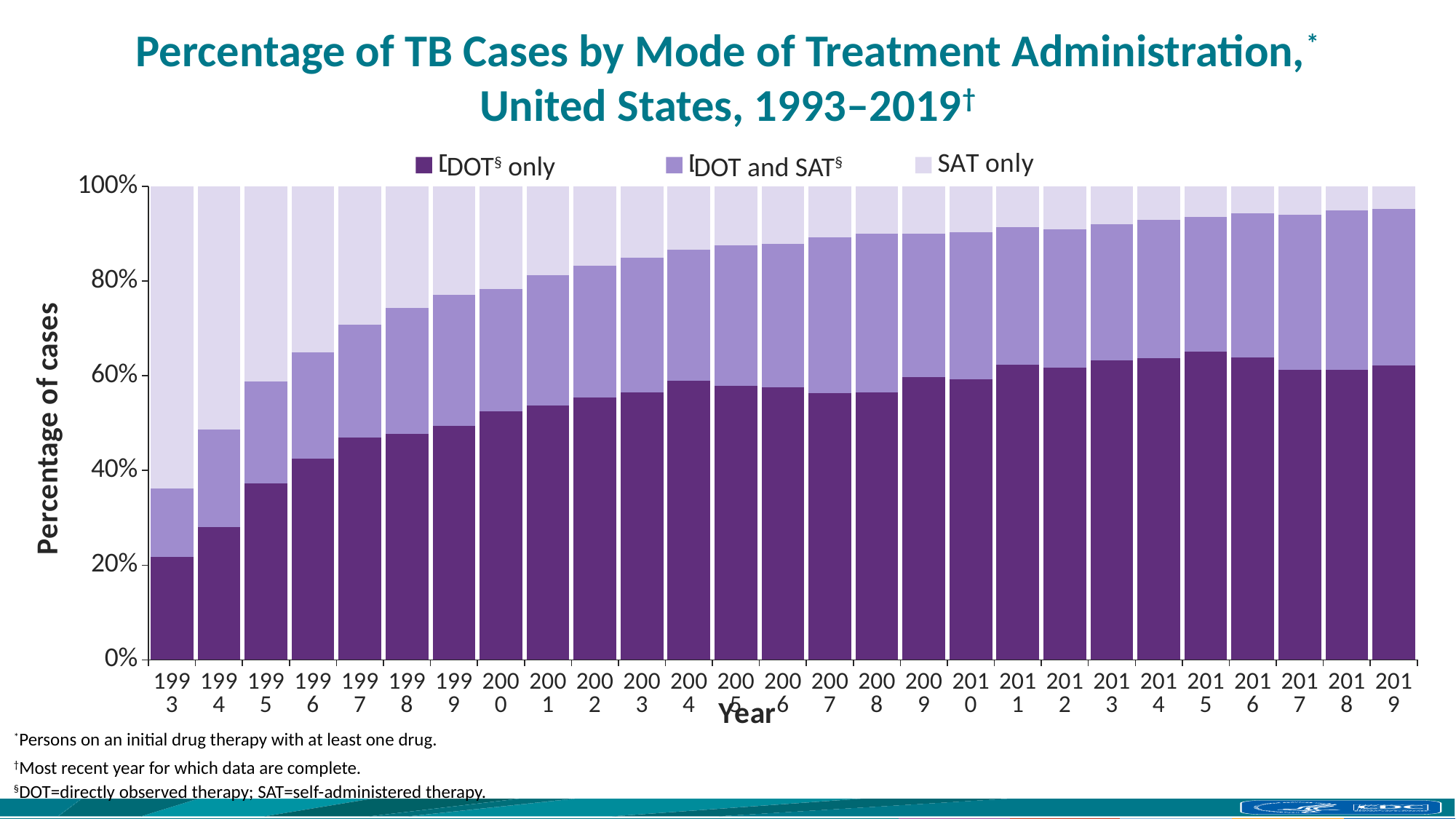
Which year has the larger DOT only share, 1993 or 2019? 2019 How many years are shown along the x axis? 27 Is the DOT only share for 1993 greater or less than 20%? greater How many series does the legend list? 3 Is the DOT only share for 1994 greater or less than 40%? less In which year is the SAT only share the largest? 1993 In which year is the DOT only share the lowest? 1993 Is the SAT only share for 1993 greater or less than 60%? greater What is the label on the y axis? Percentage of cases What kind of chart is shown on the slide? Stacked bar chart Does the DOT only share generally rise or fall from 1993 to 2019? rise